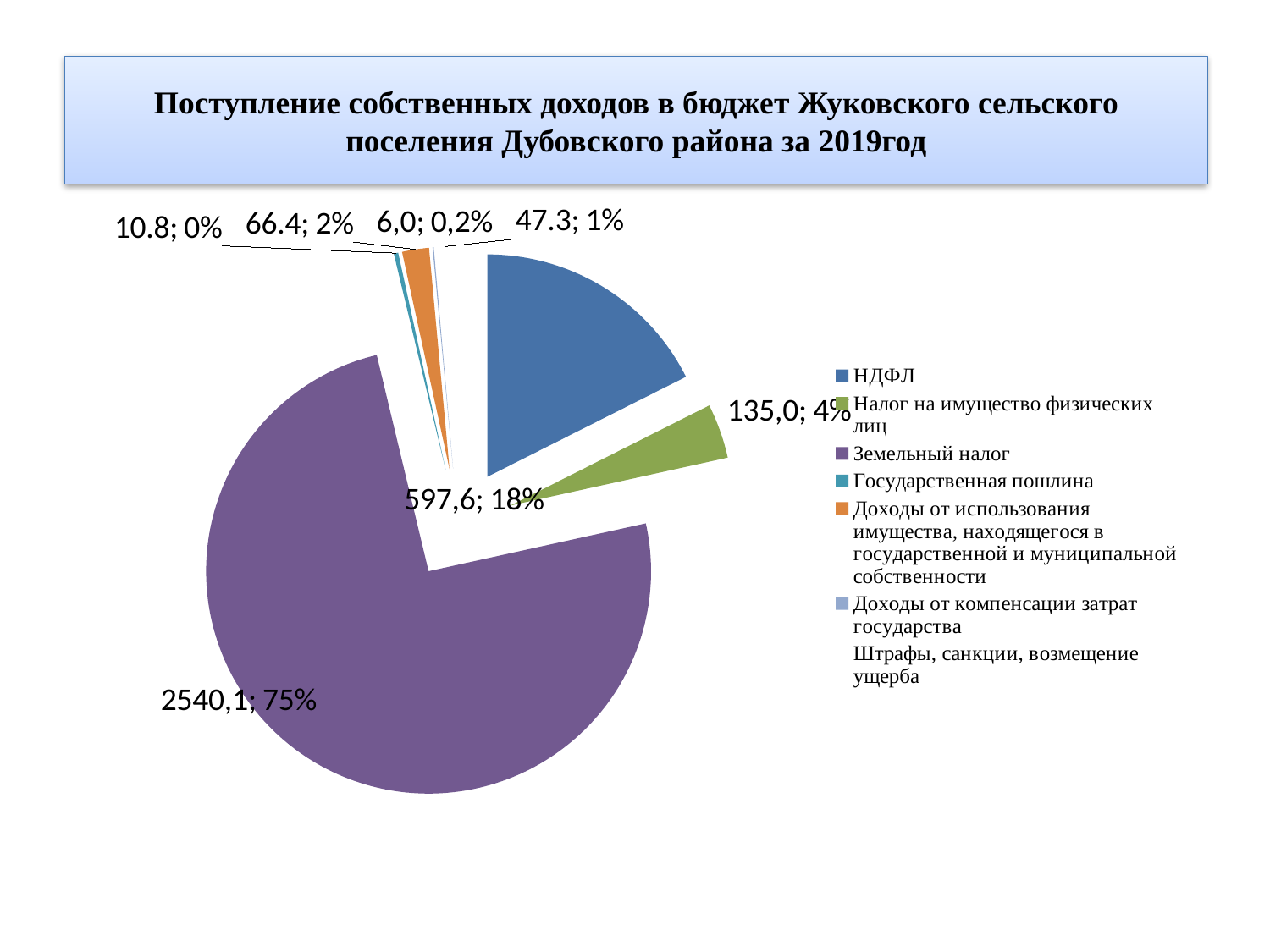
Which category has the largest slice of the pie? Земельный налог What share of the pie does НДФЛ represent? 18% What share of the pie does Земельный налог represent? 75% What is the title of the slide? Поступление собственных доходов в бюджет Жуковского сельского поселения Дубовского района за 2019год What share of the pie does Налог на имущество физических лиц represent? 4% Which is larger, НДФЛ or Налог на имущество физических лиц? НДФЛ What is the value shown for НДФЛ? 597,6 What is the value shown for Земельный налог? 2540,1 What kind of chart is shown on the slide? pie chart How many categories does the legend list? 7 What is the value shown for Налог на имущество физических лиц? 135,0 What is the difference between the values for Земельный налог and НДФЛ? 1942,5